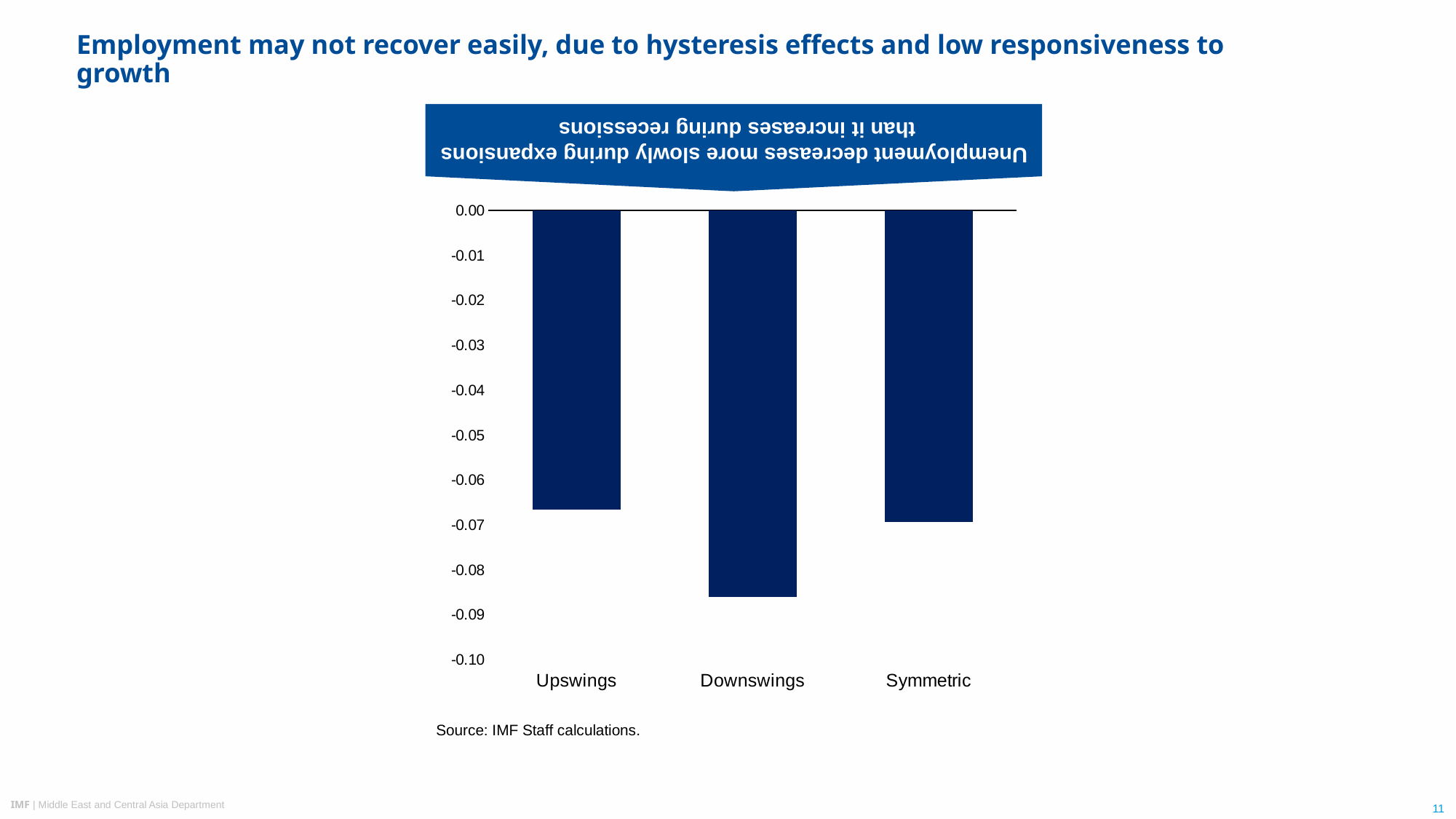
Is the value for Downswings greater or less than -0.08? less What is the source cited below the chart? IMF Staff calculations. How many categories are shown on the x axis of the chart? 3 Is the value for Downswings greater or less than -0.09? greater What are the three category labels on the x axis, from left to right? Upswings, Downswings, Symmetric Which of the two values is larger, Upswings or Downswings? Upswings Which category has the longest bar in the chart? Downswings Which of the two values is larger, Symmetric or Downswings? Symmetric Which category has the lowest (most negative) value in the chart? Downswings What kind of chart is shown on the slide? bar chart Is the value for Upswings greater or less than -0.07? greater